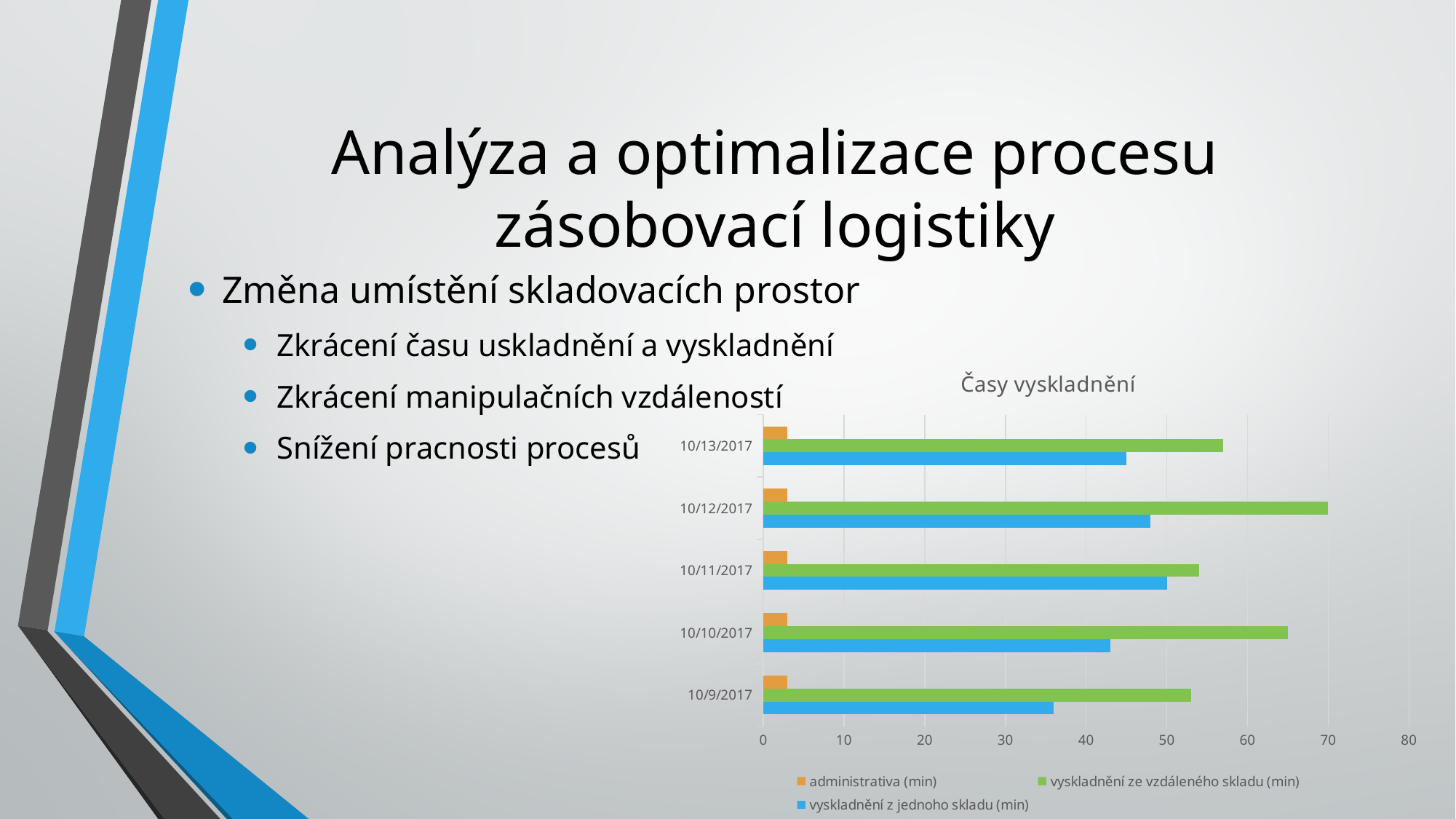
Is the value for 'vyskladnění z jednoho skladu (min)' on 10/9/2017 greater or less than 40? less Which date has the lowest value for 'vyskladnění z jednoho skladu (min)'? 10/9/2017 How many series does the chart legend list? 3 What type of chart is shown on the slide? bar chart What is the title of the chart? Časy vyskladnění Which colour represents the 'administrativa (min)' series in the chart? orange Is the value for 'administrativa (min)' on 10/11/2017 greater or less than 10? less Is the value for 'vyskladnění ze vzdáleného skladu (min)' on 10/10/2017 greater or less than 60? greater How many dates are shown on the chart's vertical axis? 5 On 10/13/2017, which is larger: 'vyskladnění ze vzdáleného skladu (min)' or 'vyskladnění z jednoho skladu (min)'? vyskladnění ze vzdáleného skladu (min) Which date has the highest value for 'vyskladnění ze vzdáleného skladu (min)'? 10/12/2017